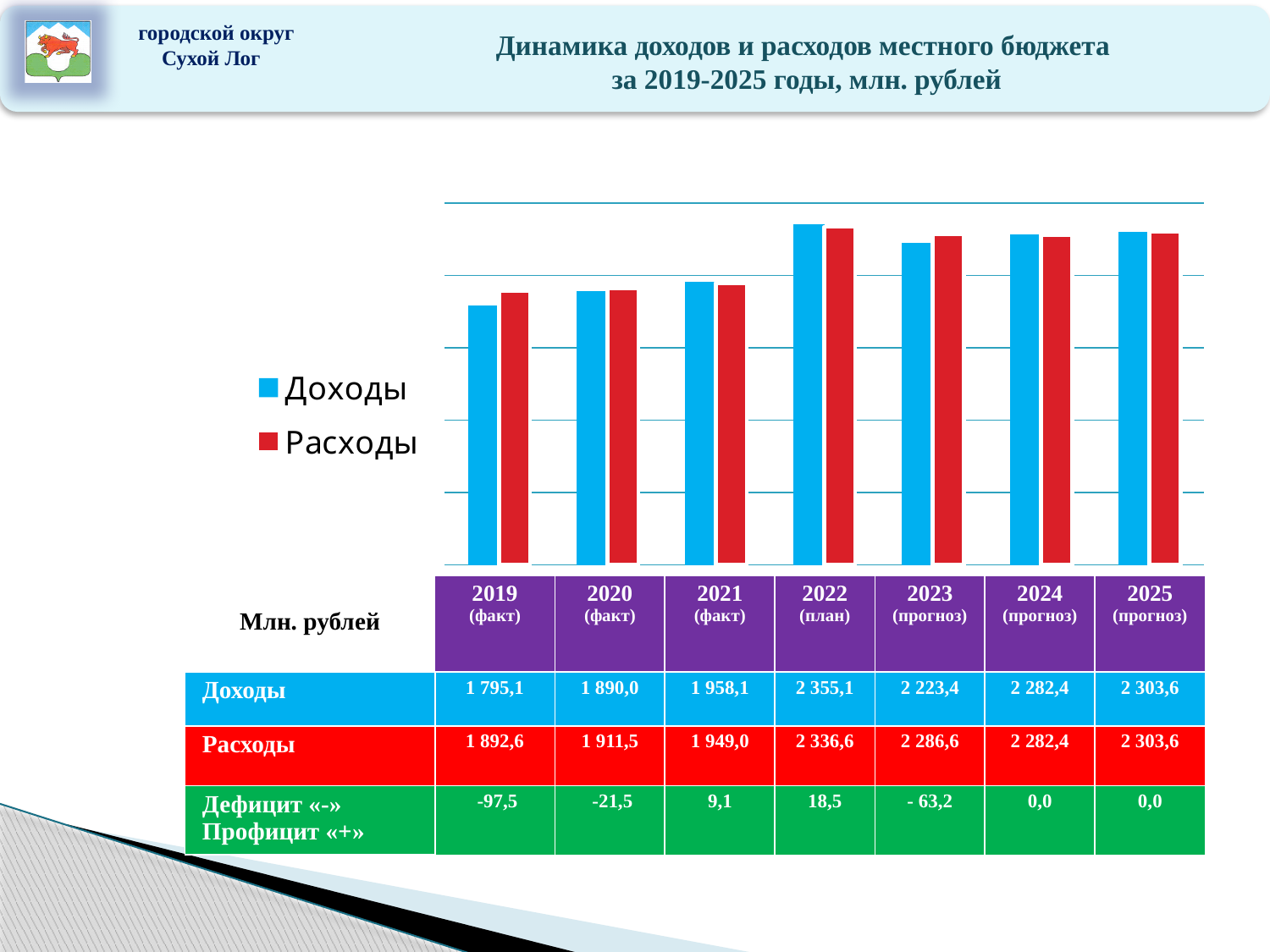
In which year is Доходы the highest? 2022 Which colour represents Расходы in the chart? red What kind of chart is shown on the slide? bar chart What is the value of Доходы for 2022 (план)? 2 355,1 How many years (categories) are shown along the x axis of the chart? 7 Do the Доходы values generally rise or fall from 2019 to 2022? rise How many series does the chart legend list? 2 Which is larger in 2019: Доходы or Расходы? Расходы What is the difference between Расходы and Доходы in 2019? 97,5 What is the value of Доходы for 2019 (факт)? 1 795,1 In which year is Расходы the lowest? 2019 What is the value of Расходы for 2023 (прогноз)? 2 286,6